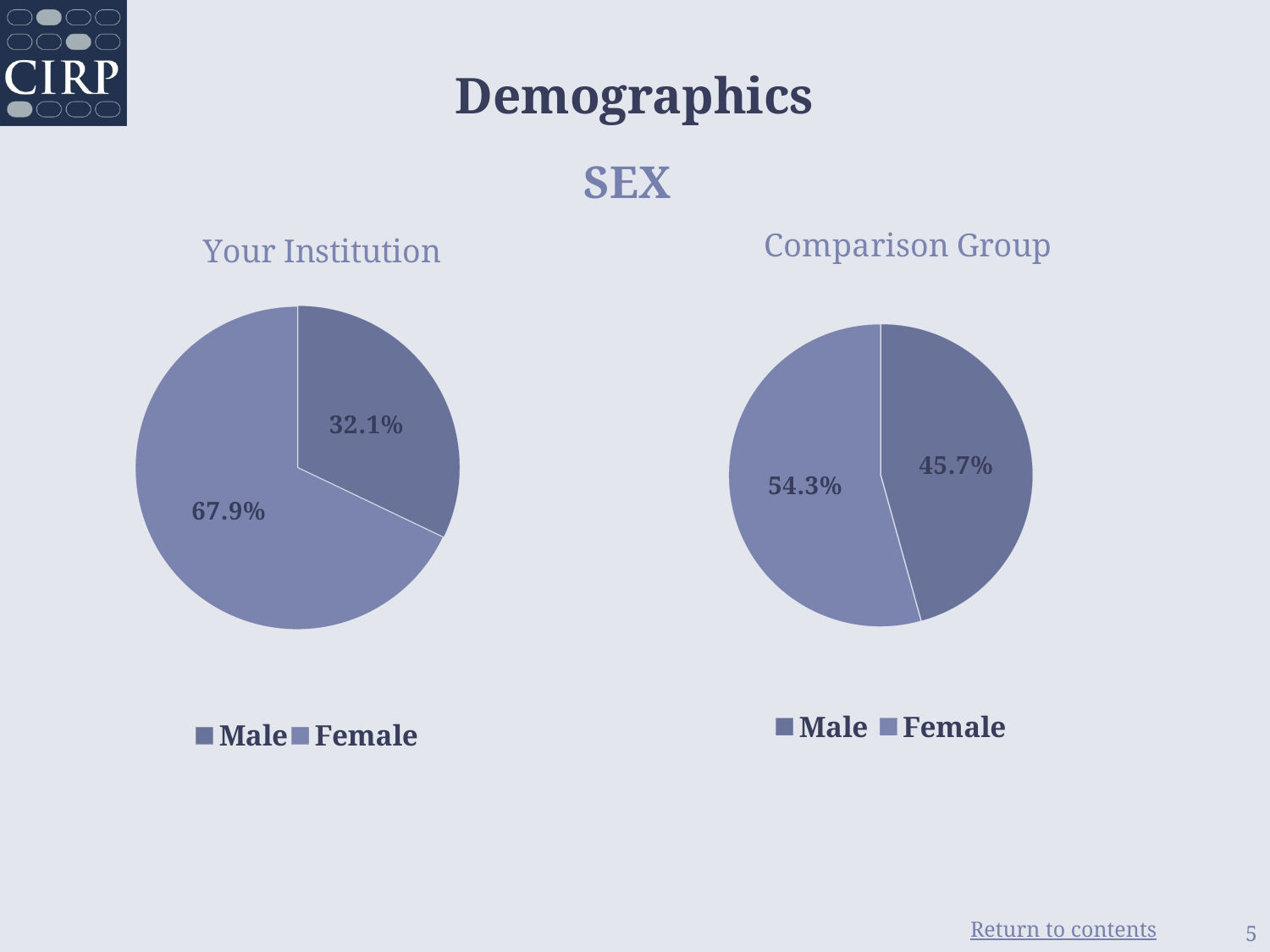
In the 'Your Institution' pie chart, what is the difference between the Female and Male percentages? 35.8% In the 'Comparison Group' pie chart, what is the difference between the Female and Male percentages? 8.6% In the 'Your Institution' pie chart, which category has the largest share? Female In the 'Your Institution' pie chart, what percentage is Female? 67.9% What type of chart is used on this slide? Pie chart What is the title of the chart on the right side of the slide? Comparison Group In the 'Comparison Group' pie chart, what percentage is Female? 54.3% How many categories does the legend of the 'Your Institution' chart list? 2 In the 'Comparison Group' pie chart, what percentage is Male? 45.7% Is the Male share larger in the 'Your Institution' chart or the 'Comparison Group' chart? Comparison Group In the 'Comparison Group' pie chart, which category has the smallest share? Male In the 'Your Institution' pie chart, what percentage is Male? 32.1%